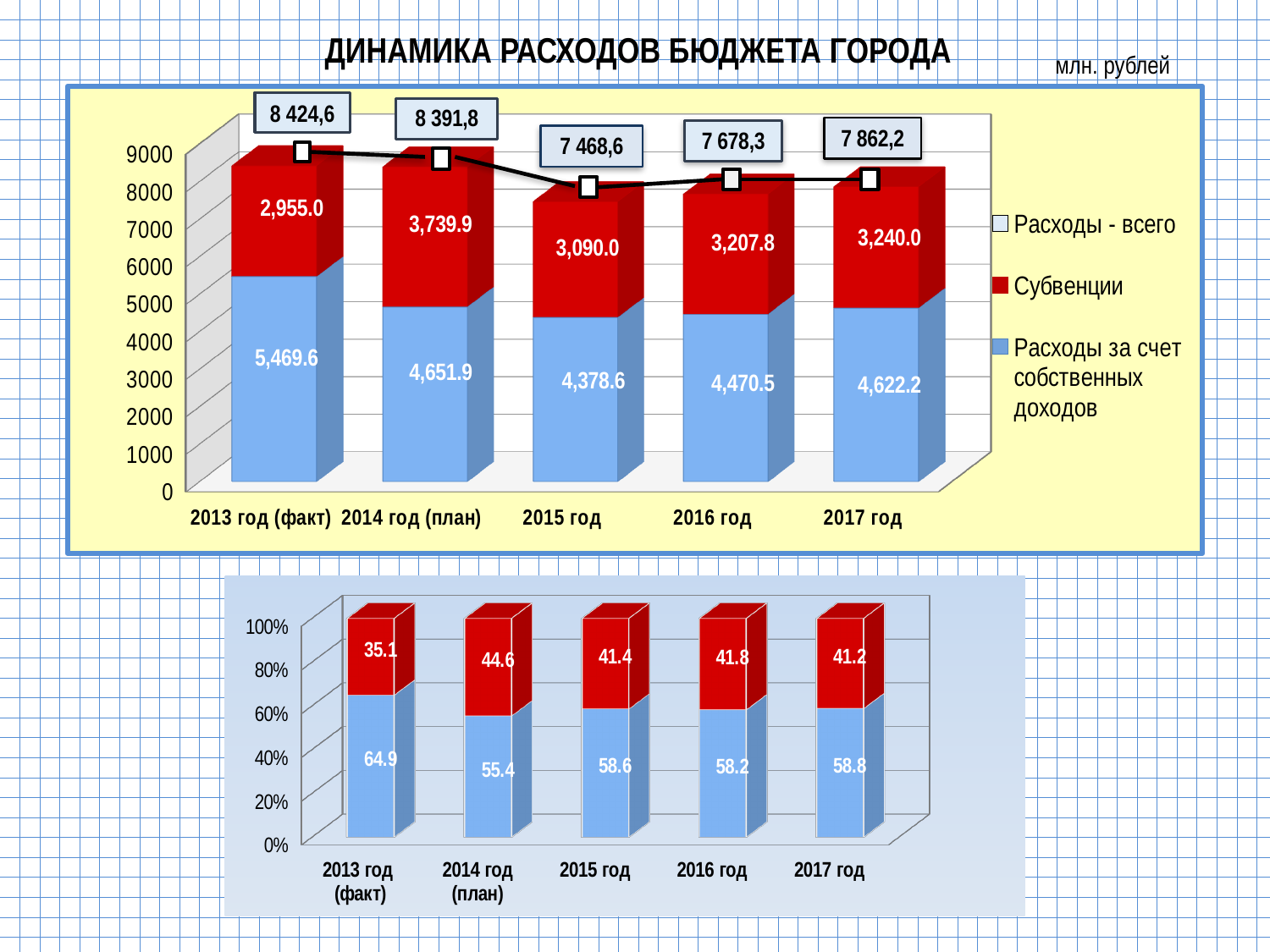
In the top chart, what is the value of Субвенции for 2014 год (план)? 3,739.9 In the top chart, is the Субвенции value larger for 2016 год or 2017 год? 2017 год In the bottom chart, which year has the highest value of the blue segment? 2013 год (факт) In the bottom chart, what is the value of the red segment for 2014 год (план)? 44.6 In the top chart, which year has the lowest value of Субвенции? 2013 год (факт) In the top chart, what is the Расходы - всего value for 2015 год? 7 468,6 In the top chart, what is the difference between Расходы за счет собственных доходов in 2013 год (факт) and 2014 год (план)? 817.7 In the top chart, which year has the highest value of Расходы за счет собственных доходов? 2013 год (факт) In the top chart, what is the value of Расходы за счет собственных доходов for 2017 год? 4,622.2 What type of chart is the bottom chart? Stacked bar chart How many years are shown on the x axis of the top chart? 5 How many series does the legend of the top chart list? 3